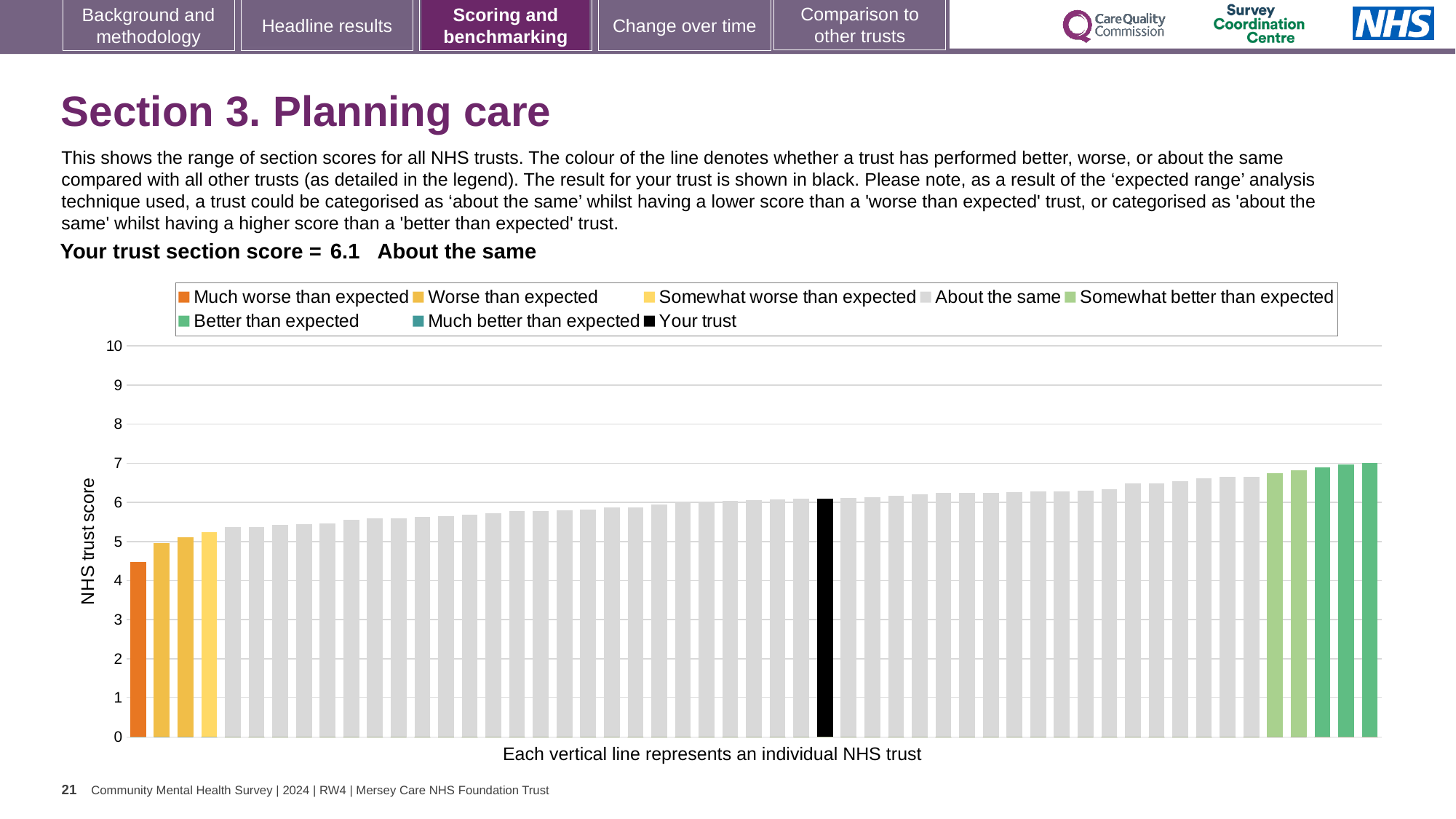
Do the bar values rise or fall moving from left to right along the x axis? rise Is the value of the lowest (orange) bar greater or less than 5? less Which category is your trust placed in for this section? About the same Is the value of the tallest bar on the right greater or less than 6? greater How many entries does the chart legend list? 8 What kind of chart is shown on the slide? bar chart What is the label on the vertical axis of the chart? NHS trust score What is the section score for your trust shown on the slide? 6.1 Is the black 'Your trust' bar higher or lower than the orange bar? higher Is the value of the black 'Your trust' bar greater or less than 7? less How many bars are coloured orange ('Much worse than expected')? 1